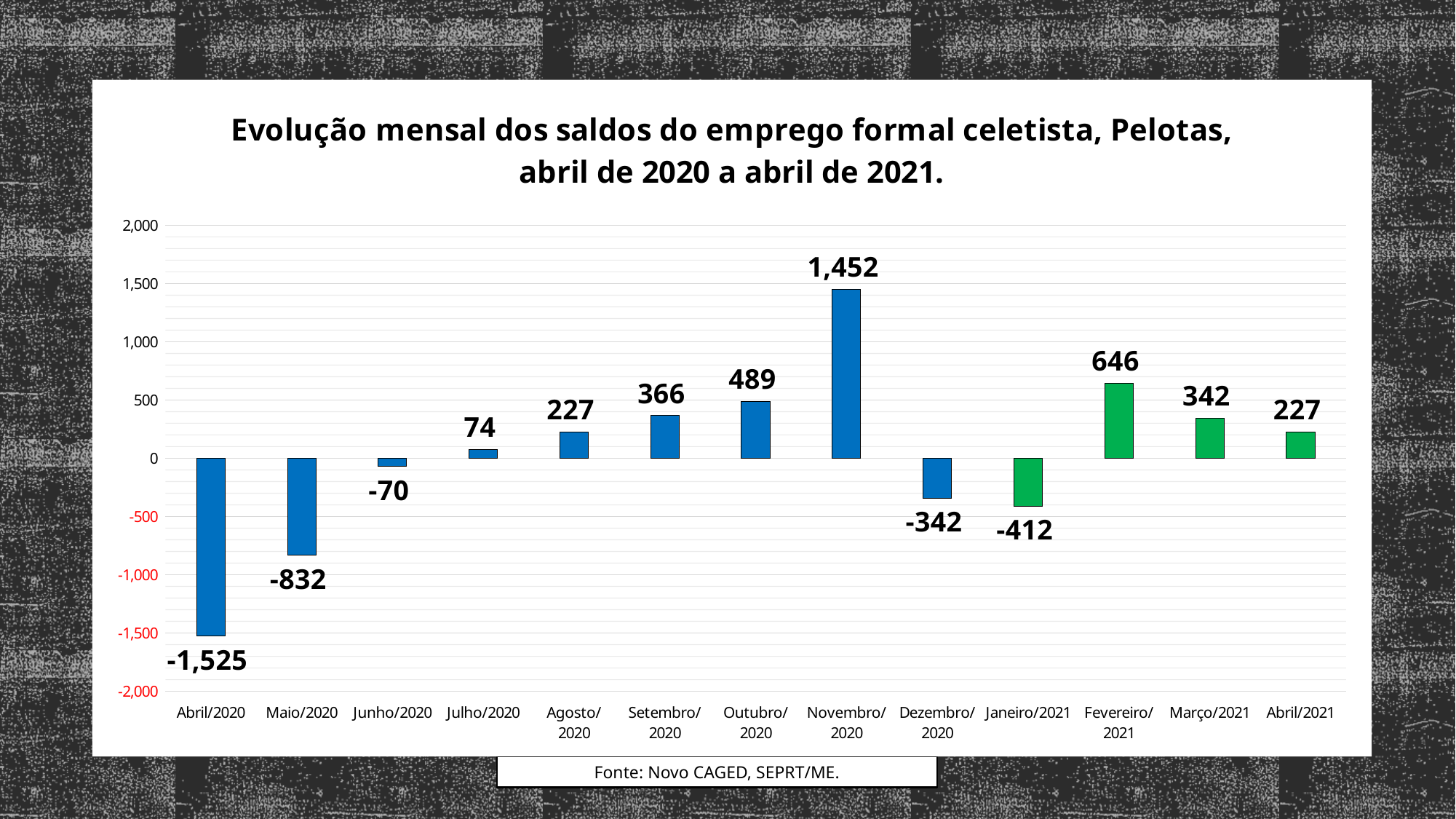
What is the value for Janeiro/2021? -412 Which month has the highest value? Novembro/2020 Which month has the lowest value? Abril/2020 What is the value for Novembro/2020? 1,452 What is the difference between the values for Novembro/2020 and Outubro/2020? 963 What source is cited below the chart? Novo CAGED, SEPRT/ME. What is the value for Abril/2020? -1,525 What kind of chart is shown on the slide? Bar chart Which is larger, the value for Setembro/2020 or the value for Março/2021? Setembro/2020 Do the values rise or fall from Abril/2020 to Novembro/2020? Rise What is the difference between the values for Fevereiro/2021 and Março/2021? 304 How many months are shown on the x axis? 13